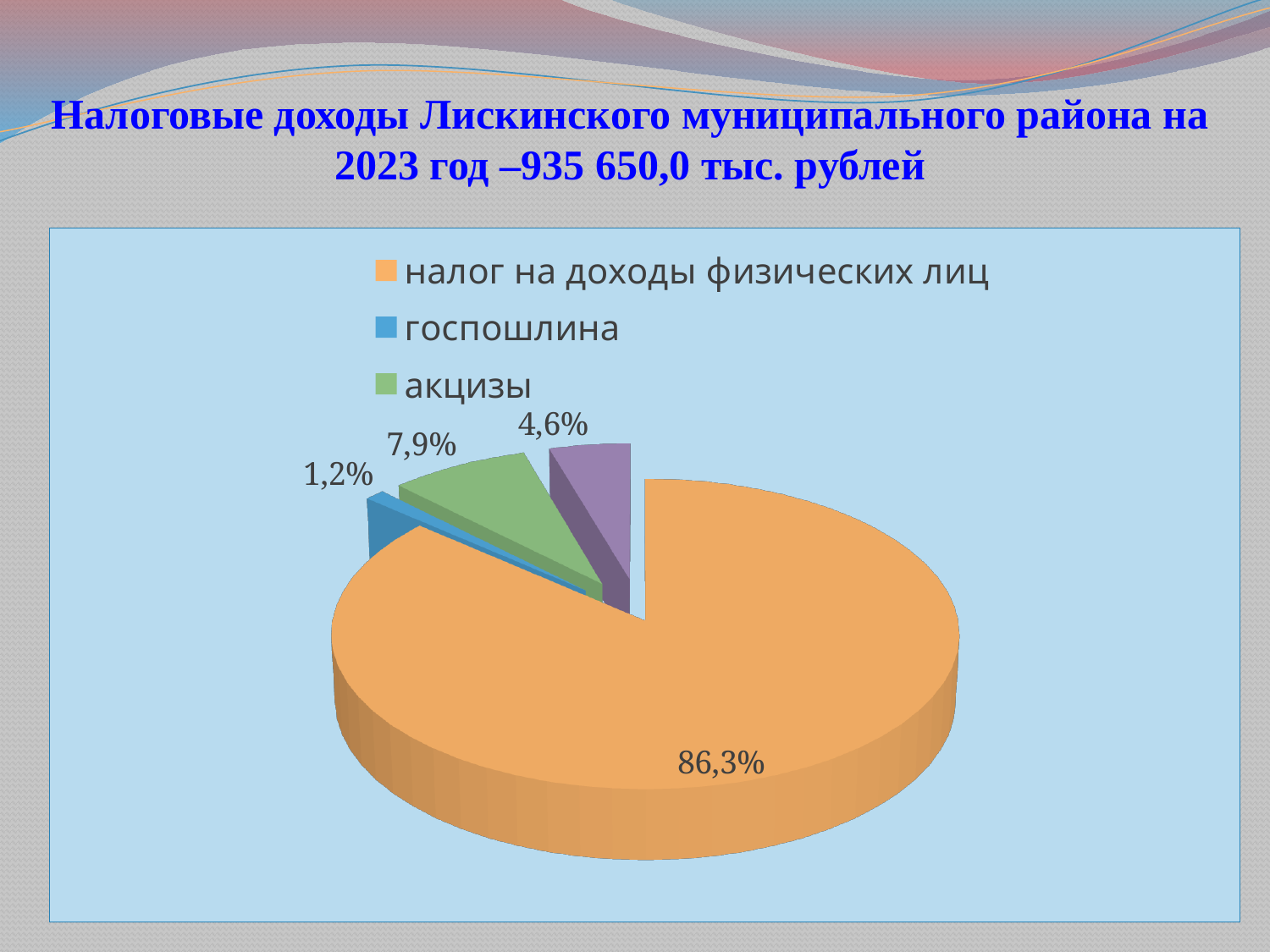
How many entries does the legend list? 3 What is the difference in percentage points between the share for налог на доходы физических лиц and the share for акцизы? 78,4 Which is larger, the share for акцизы or the share for госпошлина? акцизы Which category has the largest slice of the pie? налог на доходы физических лиц What share of the pie does налог на доходы физических лиц have? 86,3% What share of the pie does акцизы have? 7,9% How many slices does the pie chart have? 4 What share of the pie does госпошлина have? 1,2% Which category has the smallest slice of the pie? госпошлина What colour is the slice for налог на доходы физических лиц? orange What is the difference in percentage points between the share for акцизы and the share for госпошлина? 6,7 What kind of chart is shown on the slide? pie chart